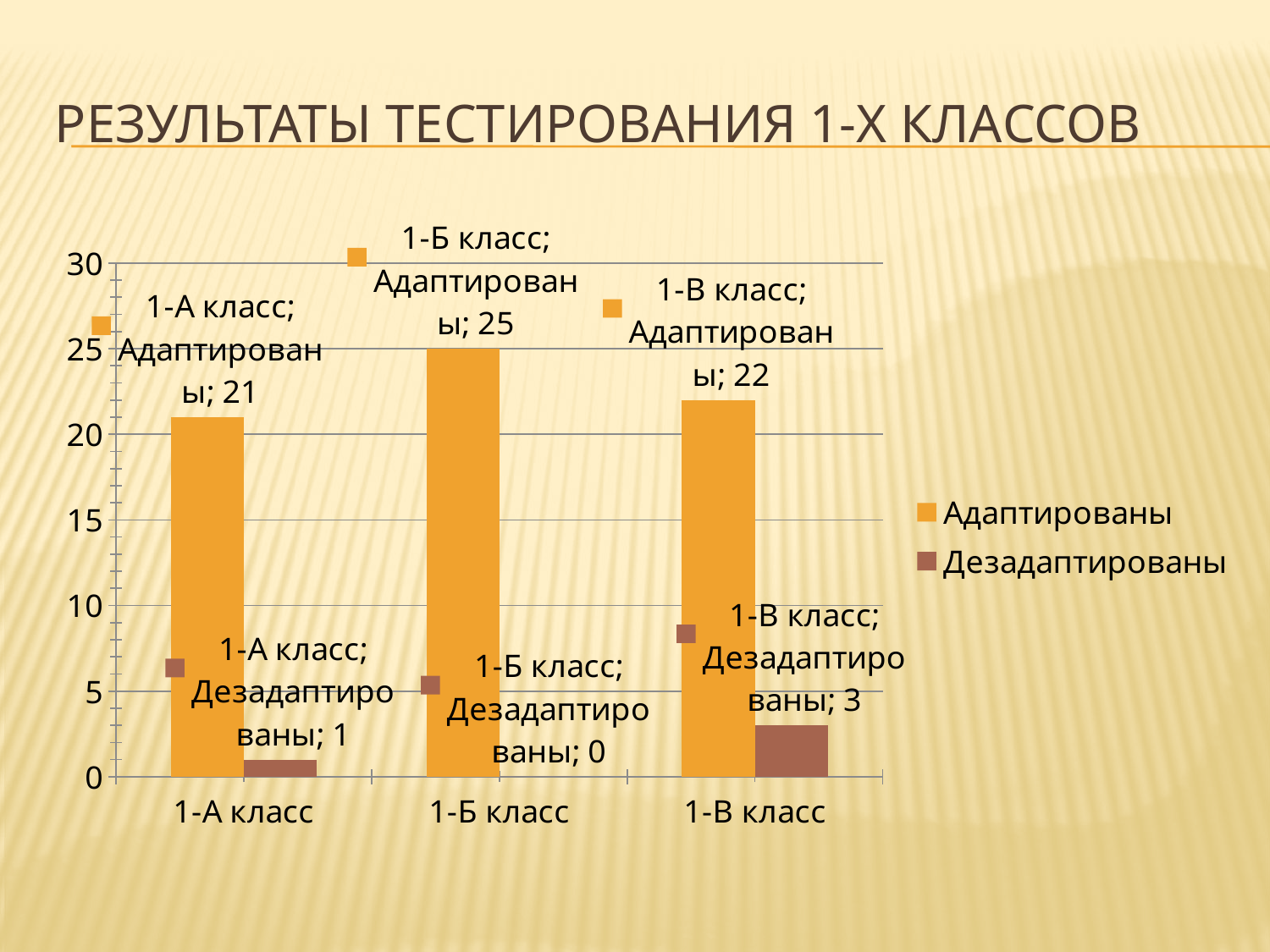
What kind of chart is shown on the slide? bar chart Which class has the highest value for Адаптированы? 1-Б класс Which is larger: the Адаптированы value for 1-В класс or for 1-А класс? 1-В класс What is the value for Адаптированы in 1-Б класс? 25 What is the difference between the Адаптированы values for 1-Б класс and 1-А класс? 4 Which class has the lowest value for Дезадаптированы? 1-Б класс What is the total of Адаптированы and Дезадаптированы for 1-В класс? 25 What is the value for Адаптированы in 1-А класс? 21 What is the value for Дезадаптированы in 1-В класс? 3 How many classes are shown on the x axis? 3 What is the value for Дезадаптированы in 1-Б класс? 0 How many series does the legend list? 2